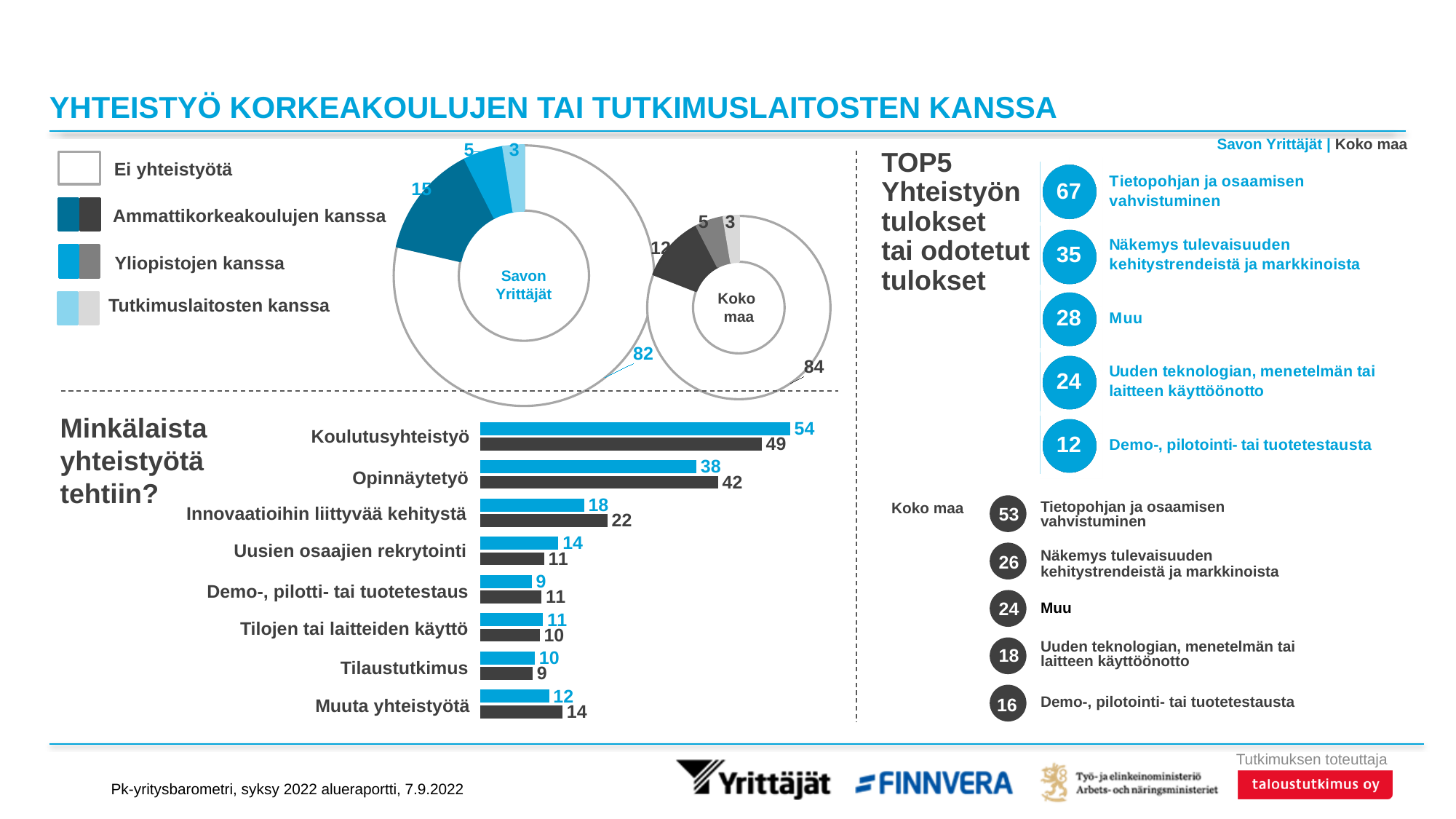
In the 'Savon Yrittäjät' donut chart, what is the value for 'Ammattikorkeakoulujen kanssa'? 15 How many categories does the legend of the donut charts list? 4 What kind of chart is 'Minkälaista yhteistyötä tehtiin?'? bar chart In the 'Savon Yrittäjät' donut chart, what is the value for 'Ei yhteistyötä'? 82 In the 'Minkälaista yhteistyötä tehtiin?' chart, what is the value of the dark grey (Koko maa) bar for 'Opinnäytetyö'? 42 In the 'Koko maa' donut chart, what is the value for 'Ammattikorkeakoulujen kanssa'? 12 In the 'Minkälaista yhteistyötä tehtiin?' chart, what is the difference between the blue and dark grey bars for 'Innovaatioihin liittyvää kehitystä'? 4 In the 'Minkälaista yhteistyötä tehtiin?' chart, which is larger for 'Uusien osaajien rekrytointi': the blue bar or the dark grey bar? the blue bar What is the difference between the 'Ei yhteistyötä' values in the 'Koko maa' and 'Savon Yrittäjät' donut charts? 2 In the 'Minkälaista yhteistyötä tehtiin?' chart, what is the value of the blue (Savon Yrittäjät) bar for 'Koulutusyhteistyö'? 54 In the 'Minkälaista yhteistyötä tehtiin?' chart, which category has the highest blue (Savon Yrittäjät) value? Koulutusyhteistyö In the 'Savon Yrittäjät' donut chart, which category has the smallest value? Tutkimuslaitosten kanssa